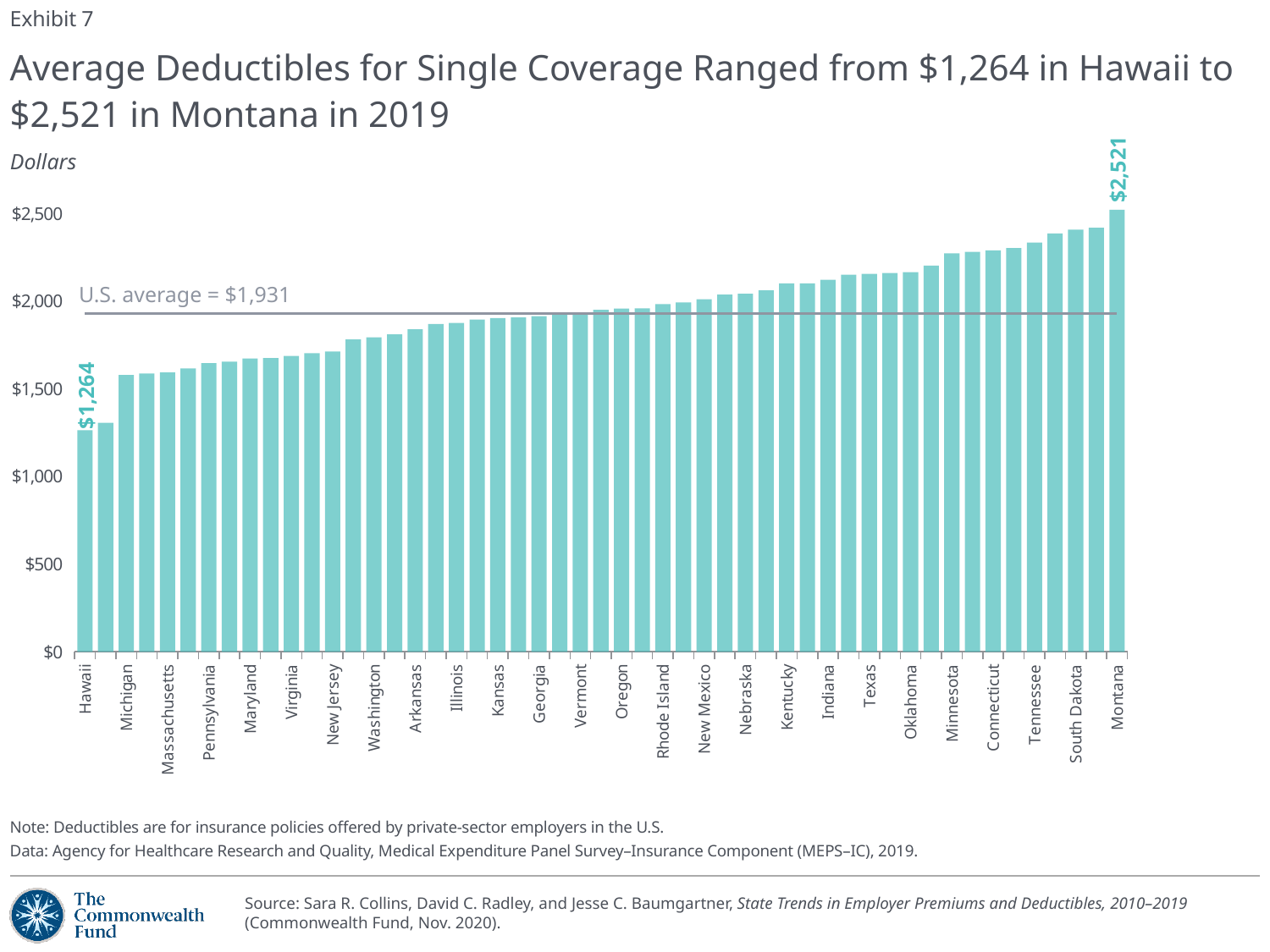
What is the average deductible for single coverage in Hawaii? $1,264 Which state has the highest average deductible? Montana Is the value for Minnesota greater or less than $2,000? greater Is the value for Kansas greater or less than $2,000? less How much higher is Montana's average deductible than the U.S. average? $590 What kind of chart is shown on the slide? Bar chart What is the average deductible for single coverage in Montana? $2,521 What is the U.S. average deductible shown by the horizontal line? $1,931 What is the difference between Montana's and Hawaii's average deductibles? $1,257 Which has a larger average deductible, Texas or Michigan? Texas Do the values rise or fall moving from left to right along the x axis? Rise Which state has the lowest average deductible? Hawaii